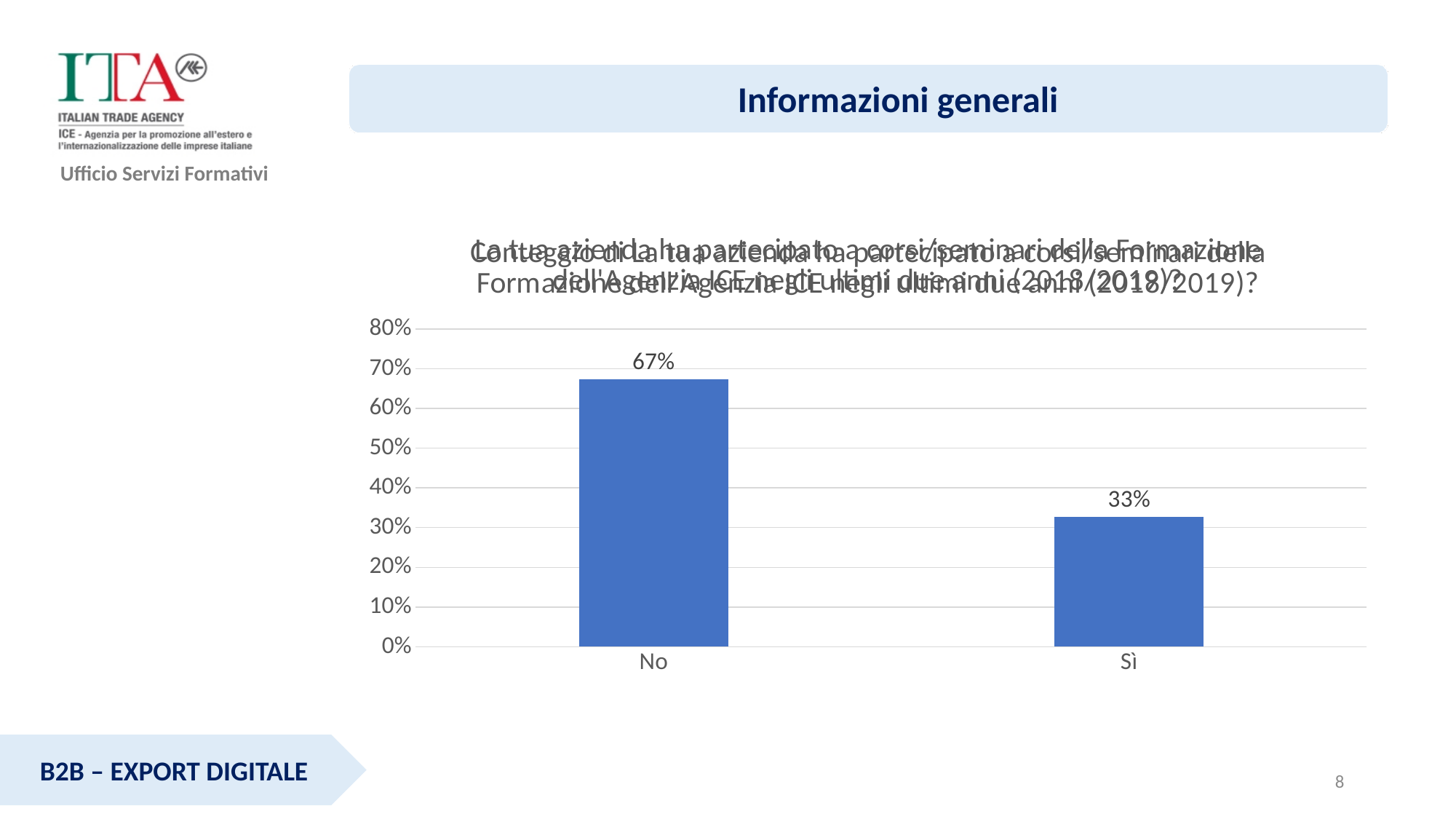
What is the highest value shown on the y axis? 80% Which is larger, the value for "No" or the value for "Sì"? No Which category has the highest value? No Is the value for "No" greater or less than 60%? greater What colour are the bars in the chart? blue How many categories are shown on the x axis? 2 What is the value for "Sì"? 33% Is the value for "Sì" greater or less than 40%? less What is the difference between the values for "No" and "Sì"? 34% Which category has the lowest value? Sì What is the value for "No"? 67% What kind of chart is shown on the slide? bar chart